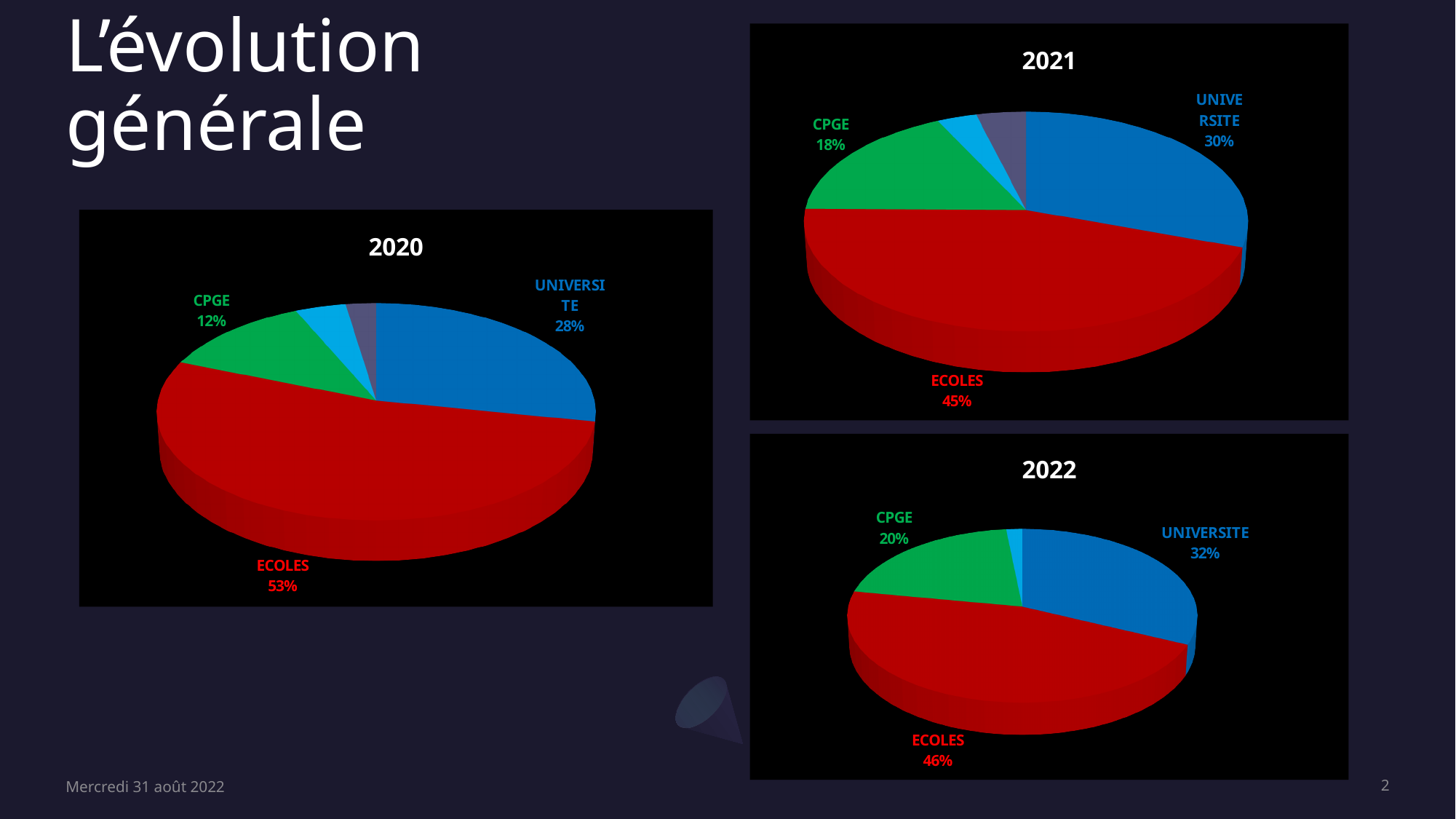
In the 2020 chart, which is larger, the UNIVERSITE share or the CPGE share? UNIVERSITE What kind of chart is the 2021 chart? Pie chart How does the CPGE share change from the 2020 chart to the 2022 chart? It rises (12% to 20%) In the 2022 chart, what share is labelled for UNIVERSITE? 32% In the 2021 chart, what colour is the ECOLES slice? Red In the 2021 chart, which labelled category has the largest share? ECOLES In the 2022 chart, how many slices have a printed label? 3 What is the title of the chart on the left of the slide? 2020 In the 2020 chart, which labelled category has the smallest share? CPGE In the 2021 chart, what share is labelled for CPGE? 18% In the 2022 chart, what is the difference between the ECOLES share and the CPGE share? 26% In the 2020 chart, what share is labelled for ECOLES? 53%